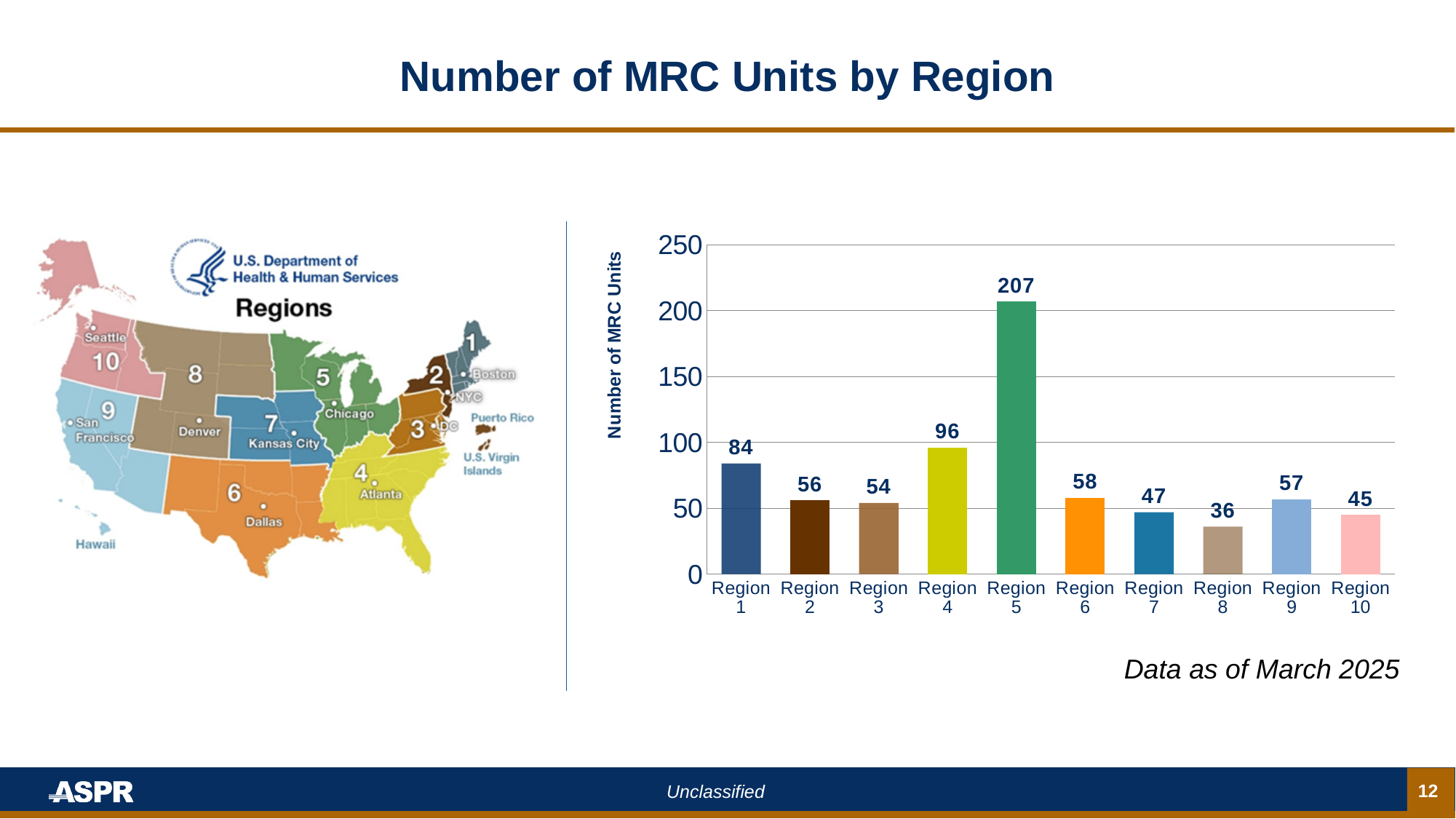
How many regions are shown on the bar chart? 10 What is the label of the vertical axis of the chart? Number of MRC Units Which region has the lowest number of MRC units? Region 8 How many MRC units does Region 5 have? 207 What is the difference in MRC units between Region 5 and Region 4? 111 What is the number of MRC units for Region 8? 36 What kind of chart is used to show the number of MRC units by region? bar chart Which has more MRC units, Region 4 or Region 6? Region 4 Is the value for Region 7 greater or less than 50? less Which region has the highest number of MRC units? Region 5 What is the number of MRC units for Region 1? 84 What is the difference in MRC units between Region 1 and Region 10? 39